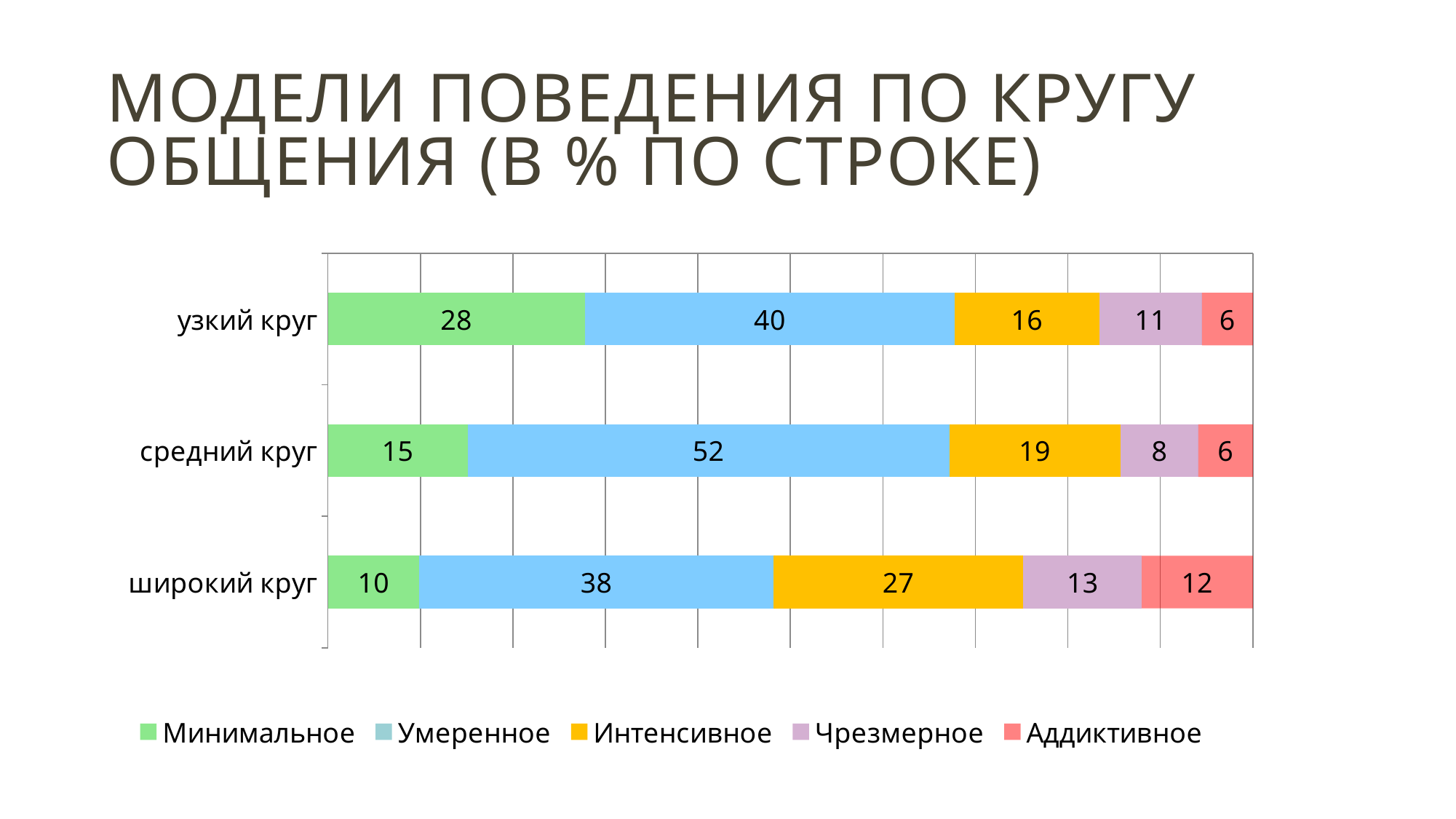
What is the value of Умеренное for средний круг? 52 Which is larger: Чрезмерное for узкий круг or Чрезмерное for средний круг? узкий круг How many series does the legend list? 5 What is the value of Минимальное for узкий круг? 28 What is the total of the stacked bar for средний круг? 100 Which category has the highest value for Интенсивное? широкий круг What kind of chart is shown on the slide? stacked bar chart How many categories are shown on the y axis? 3 What is the difference between the Умеренное values for средний круг and широкий круг? 14 What is the value of Аддиктивное for широкий круг? 12 Which category has the lowest value for Минимальное? широкий круг Which series is shown in yellow? Интенсивное